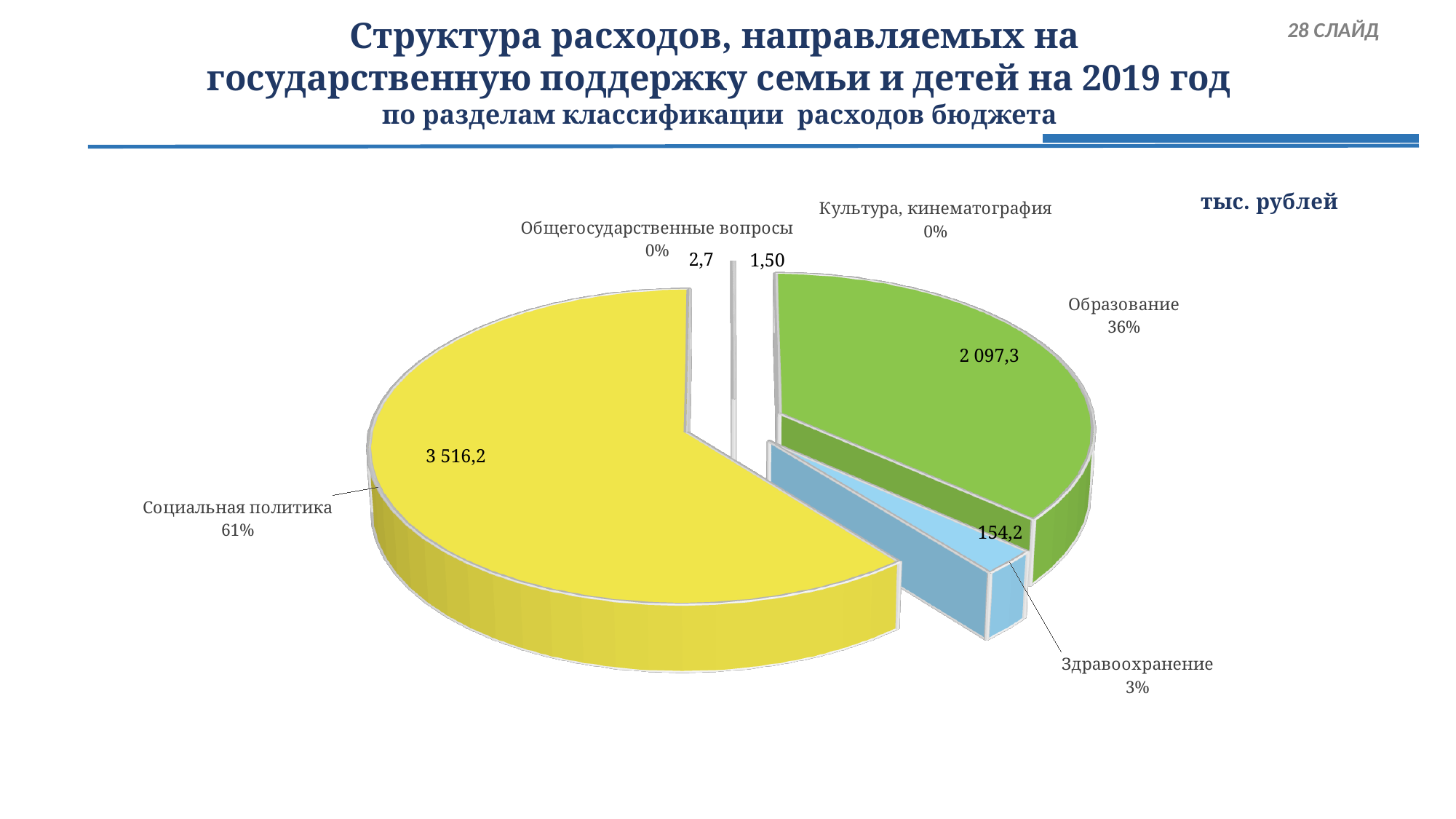
What is the difference between the values for Социальная политика and Образование? 1 418,9 Which category has the largest share of the pie? Социальная политика What is the value for Здравоохранение? 154,2 What share of the pie does Образование represent? 36% What is the value for Образование? 2 097,3 What is the value for Социальная политика? 3 516,2 What is the value for Общегосударственные вопросы? 2,7 What is the value for Культура, кинематография? 1,50 What type of chart is shown on the slide? Pie chart In what units are the values on the chart given? тыс. рублей Which category has the smallest value? Культура, кинематография How many categories (slices) does the pie chart have? 5